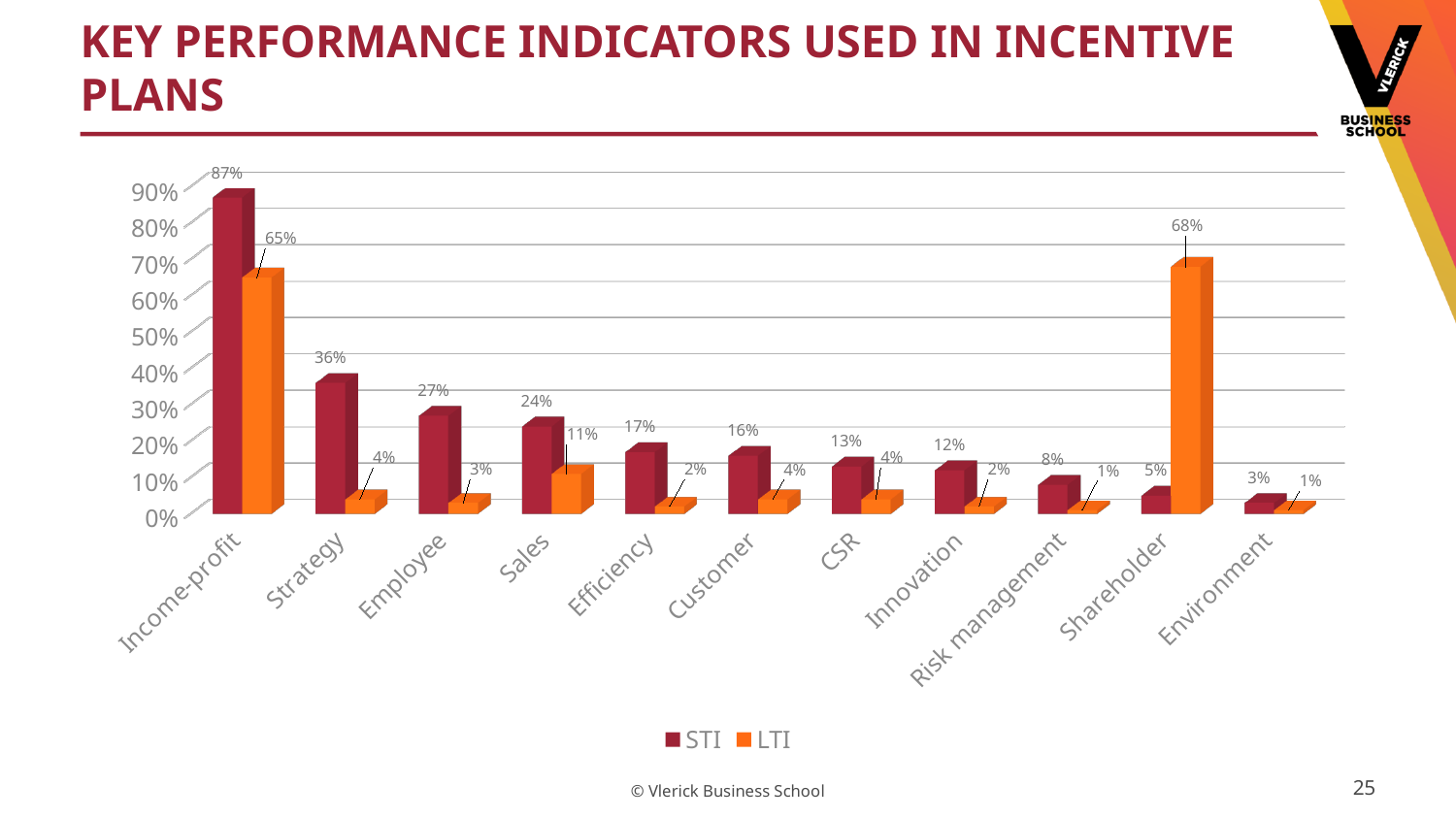
Which category has the highest LTI value? Shareholder What is the STI value for Income-profit? 87% Which is larger for Shareholder, the STI value or the LTI value? LTI Which category has the highest STI value? Income-profit What is the title of the chart on the slide? Key performance indicators used in incentive plans What is the LTI value for Sales? 11% What is the LTI value for Shareholder? 68% How many categories are shown on the x axis? 11 What is the difference between the STI and LTI values for Income-profit? 22% What is the STI value for Risk management? 8% How many series does the legend list? 2 What kind of chart is shown on the slide? Bar chart